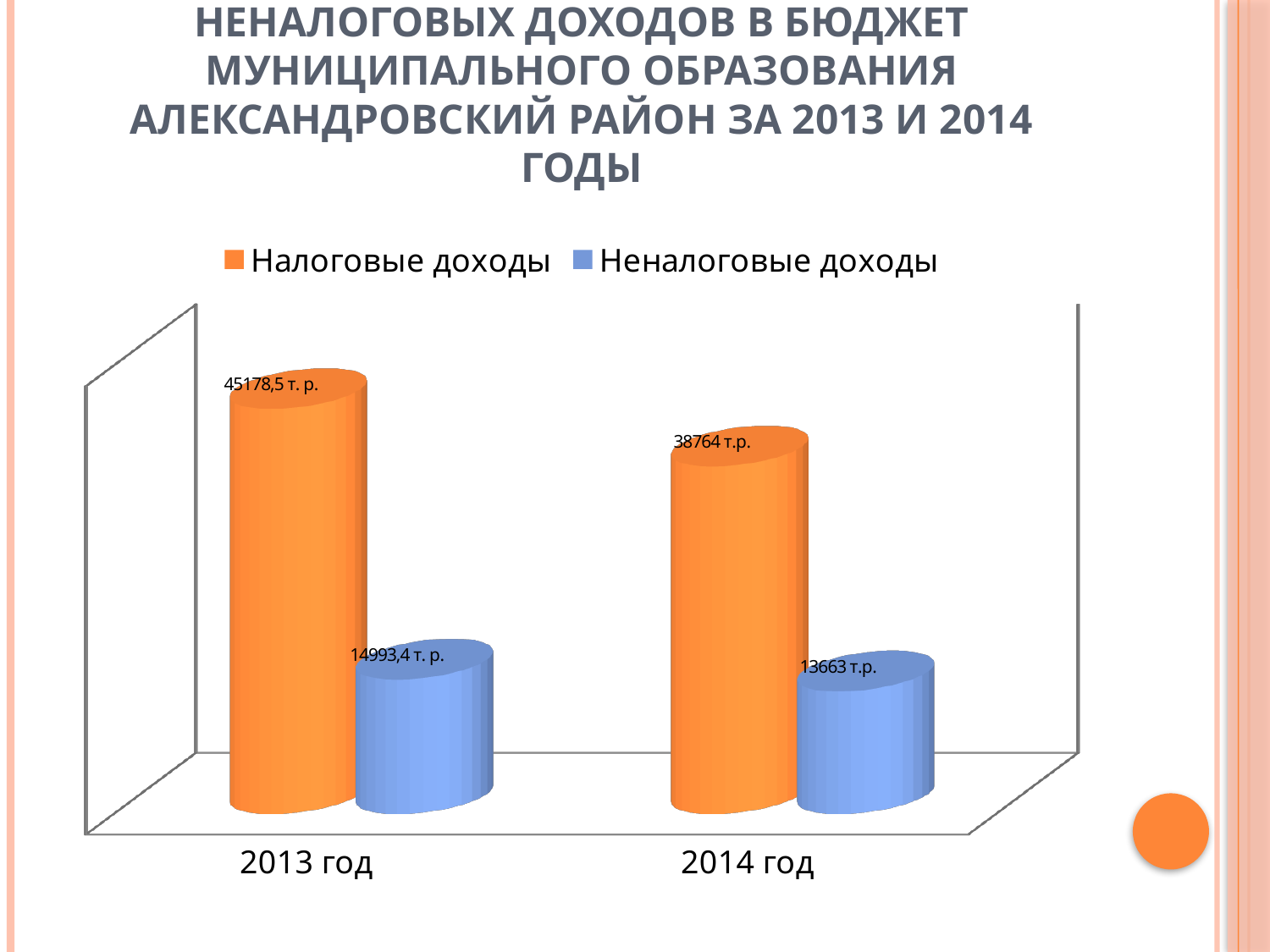
In which year is Налоговые доходы highest? 2013 год What kind of chart is shown on the slide? Bar chart What is the value of Налоговые доходы for 2014 год? 38764 т.р. Do the values for Неналоговые доходы rise or fall from 2013 год to 2014 год? Fall What is the value of Неналоговые доходы for 2014 год? 13663 т.р. In which year is Неналоговые доходы lowest? 2014 год Which is larger in 2013 год: Налоговые доходы or Неналоговые доходы? Налоговые доходы What is the difference between Налоговые доходы and Неналоговые доходы in 2014 год? 25101 т.р. How many series does the legend list? 2 What is the value of Налоговые доходы for 2013 год? 45178,5 т. р. What is the value of Неналоговые доходы for 2013 год? 14993,4 т. р. By how much did Налоговые доходы decrease from 2013 год to 2014 год? 6414,5 т. р.